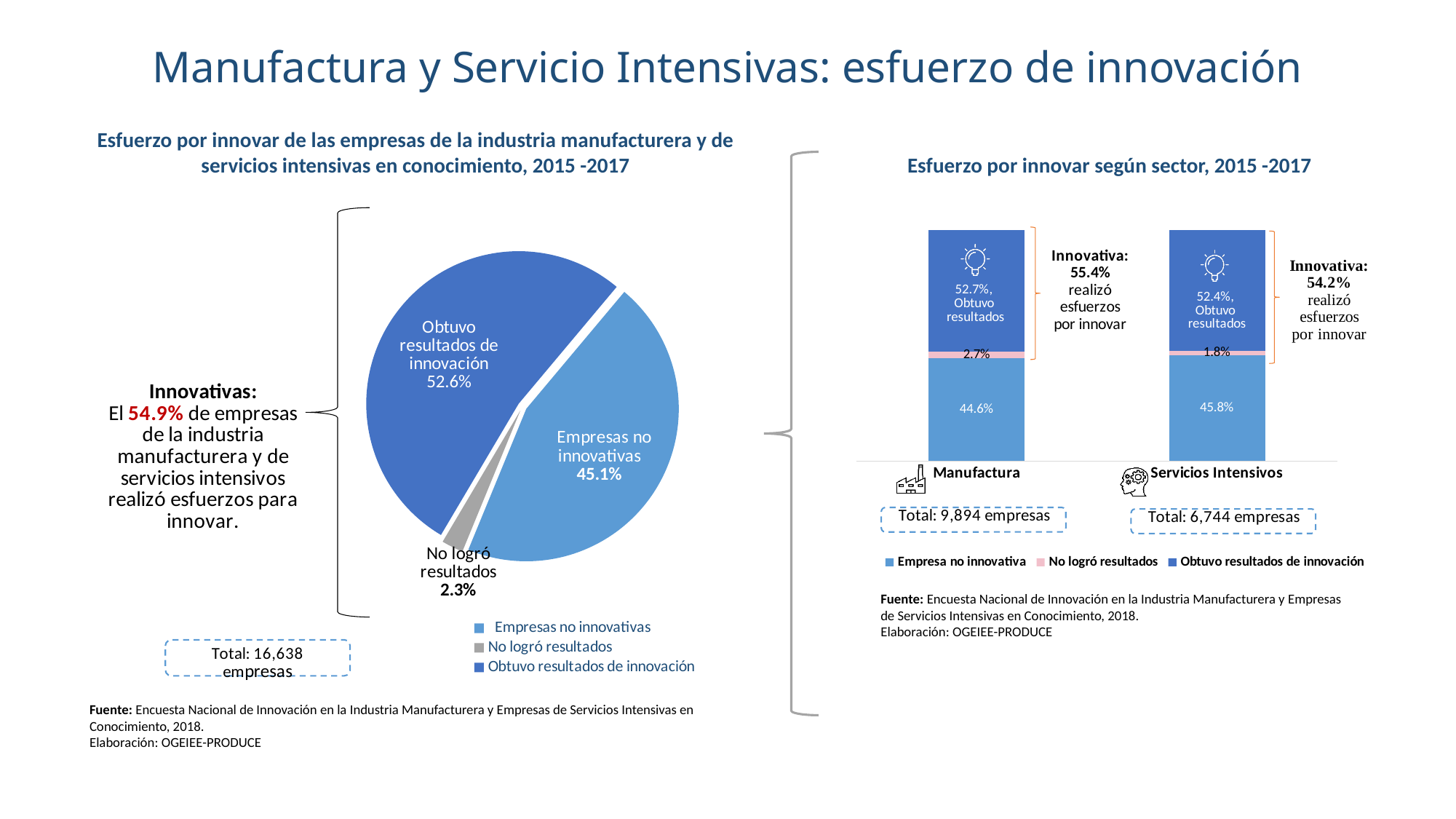
In the pie chart on the left, what is the difference in percentage points between 'Obtuvo resultados de innovación' and 'Empresas no innovativas'? 7.5 In the bar chart on the right, how many sectors (bars) are shown? 2 In the bar chart on the right, what percentage of Manufactura companies are 'Empresa no innovativa'? 44.6% In the pie chart on the left, what share of companies is labelled 'Empresas no innovativas'? 45.1% In the pie chart on the left, which slice is the largest? Obtuvo resultados de innovación In the bar chart on the right, which sector has the higher share of 'Obtuvo resultados' companies, Manufactura or Servicios Intensivos? Manufactura In the bar chart on the right, what percentage of Servicios Intensivos companies 'No logró resultados'? 1.8% In the pie chart on the left, what percentage is shown for 'No logró resultados'? 2.3% In the pie chart on the left, which slice is the smallest? No logró resultados In the bar chart on the right, what is the total number of companies shown for Servicios Intensivos? 6,744 empresas In the bar chart on the right, how many series does the legend list? 3 What type of chart is shown on the left side of the slide? Pie chart